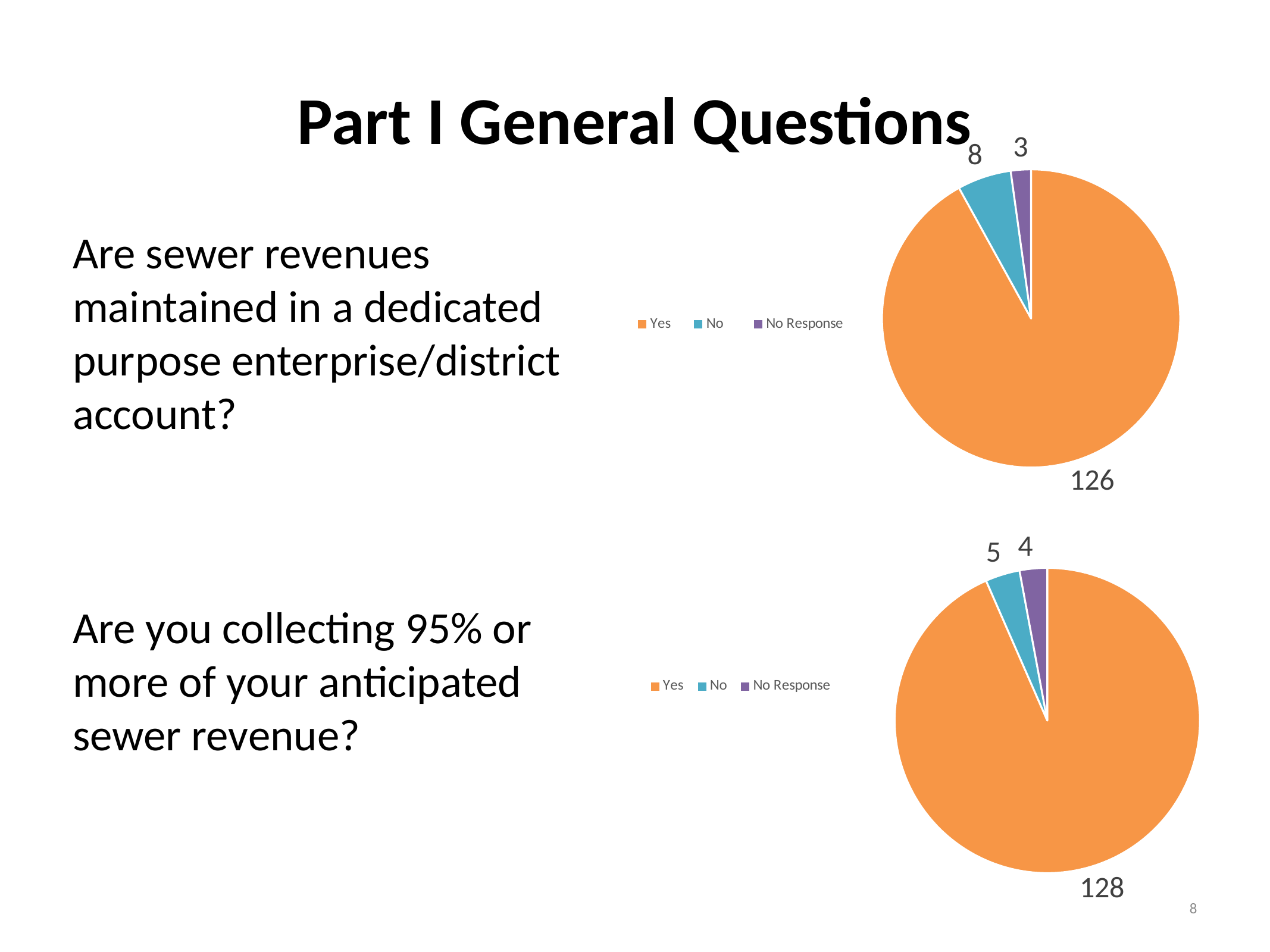
What type of chart is used for the top chart on the slide? pie chart How many categories does the legend of the bottom pie chart list? 3 In the bottom pie chart (collecting 95% or more of anticipated revenue), what is the value for Yes? 128 In the top pie chart (sewer revenues in a dedicated account), what is the value for Yes? 126 In the top pie chart, which category has the largest slice? Yes In the bottom pie chart, which category has the smallest slice? No Response In the bottom pie chart, is the value for No larger or smaller than the value for No Response? larger In the bottom pie chart (collecting 95% or more of anticipated revenue), what is the value for No? 5 In the top pie chart, what is the difference between the Yes and No values? 118 In the bottom pie chart (collecting 95% or more of anticipated revenue), what is the value for No Response? 4 In the top pie chart (sewer revenues in a dedicated account), what is the value for No? 8 In the top pie chart (sewer revenues in a dedicated account), what is the value for No Response? 3